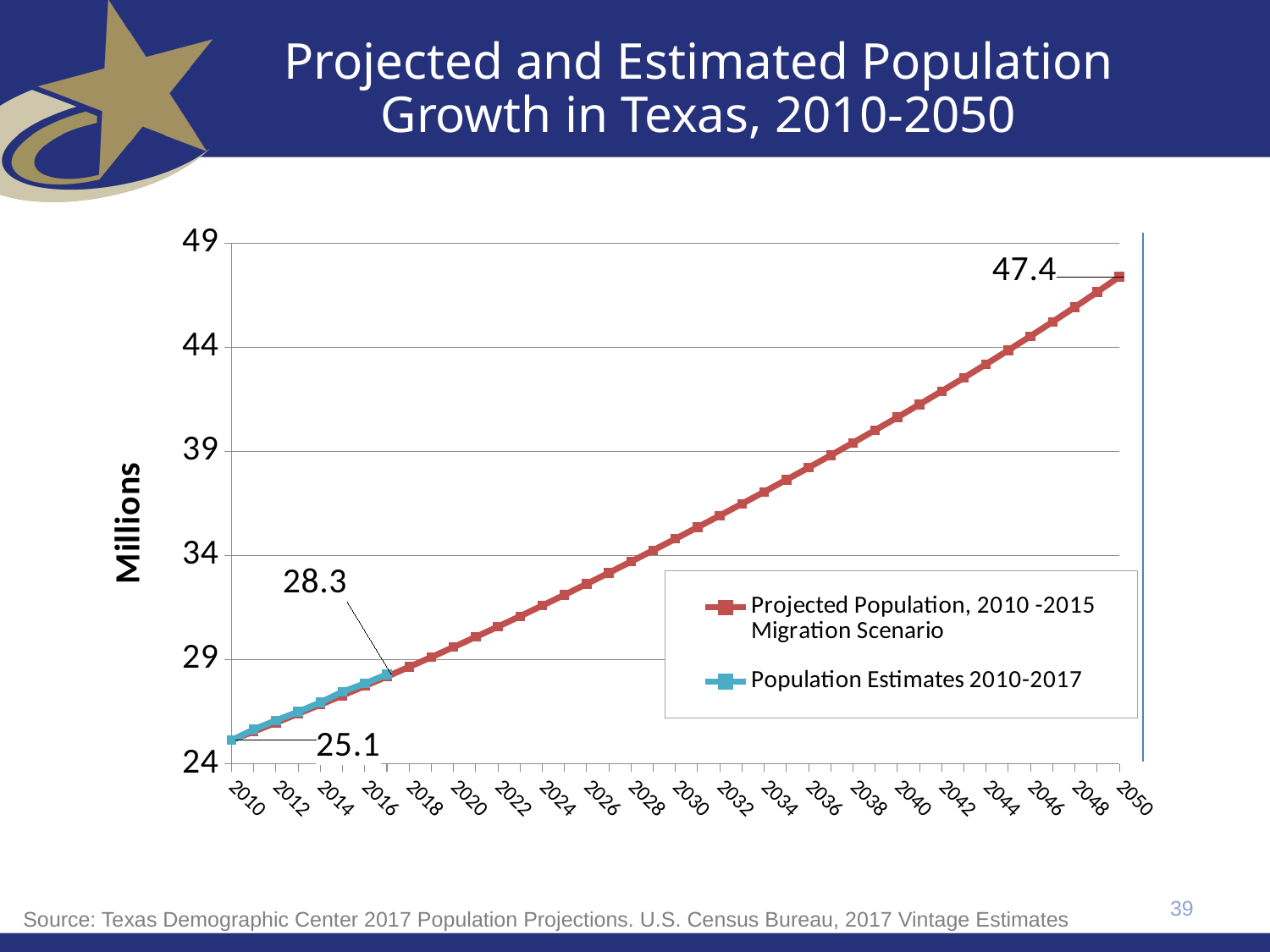
Which year has the highest projected population on the chart? 2050 Is the projected population value for 2030 greater or less than 34? greater What is the difference between the labeled 2050 value (47.4) and the labeled 2010 value (25.1)? 22.3 Is the projected population value for 2024 greater or less than 34? less How many series does the legend list? 2 What is the difference between the labeled value 28.3 and the labeled value 25.1? 3.2 What is the projected population value labeled for 2050? 47.4 What is the value labeled at the end of the Population Estimates 2010-2017 series? 28.3 Does the projected population rise or fall from 2010 to 2050? rise What is the population value labeled at the start of the series in 2010? 25.1 Is the projected population value for 2040 greater or less than 39? greater What kind of chart is shown on the slide? line chart